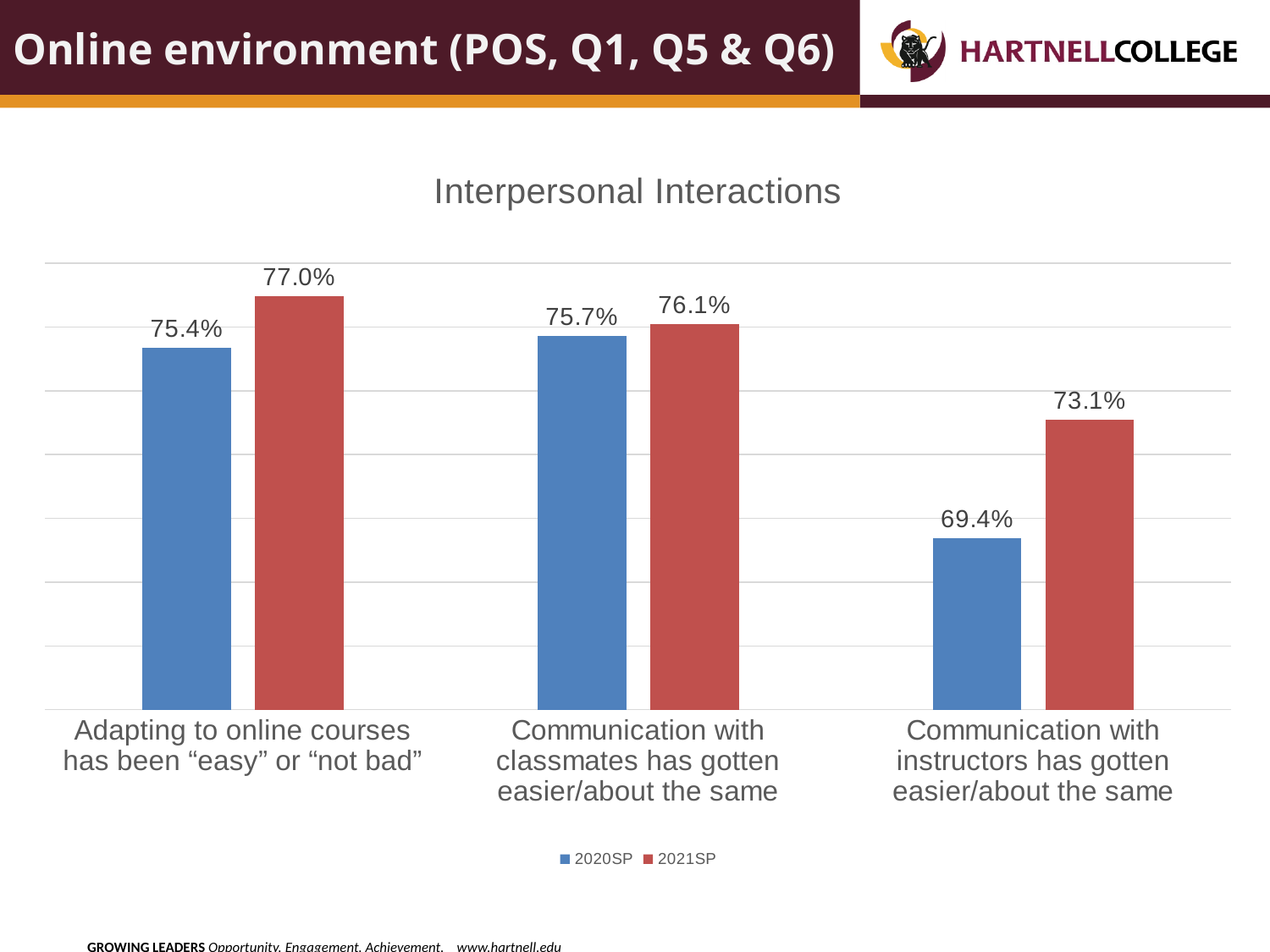
What is the 2021SP value for "Communication with classmates has gotten easier/about the same"? 76.1% How many categories are shown on the x axis? 3 What is the difference between the 2021SP and 2020SP values for "Adapting to online courses has been "easy" or "not bad""? 1.6% What is the 2020SP value for "Communication with instructors has gotten easier/about the same"? 69.4% What is the 2020SP value for "Adapting to online courses has been "easy" or "not bad""? 75.4% How many series does the legend list? 2 Which category has the lowest 2020SP value? Communication with instructors has gotten easier/about the same What type of chart is shown on the slide? Bar chart For "Communication with instructors has gotten easier/about the same", which series has the larger value, 2020SP or 2021SP? 2021SP Which category has the highest 2021SP value? Adapting to online courses has been "easy" or "not bad" What is the 2021SP value for "Communication with instructors has gotten easier/about the same"? 73.1% What is the difference between the 2021SP and 2020SP values for "Communication with instructors has gotten easier/about the same"? 3.7%